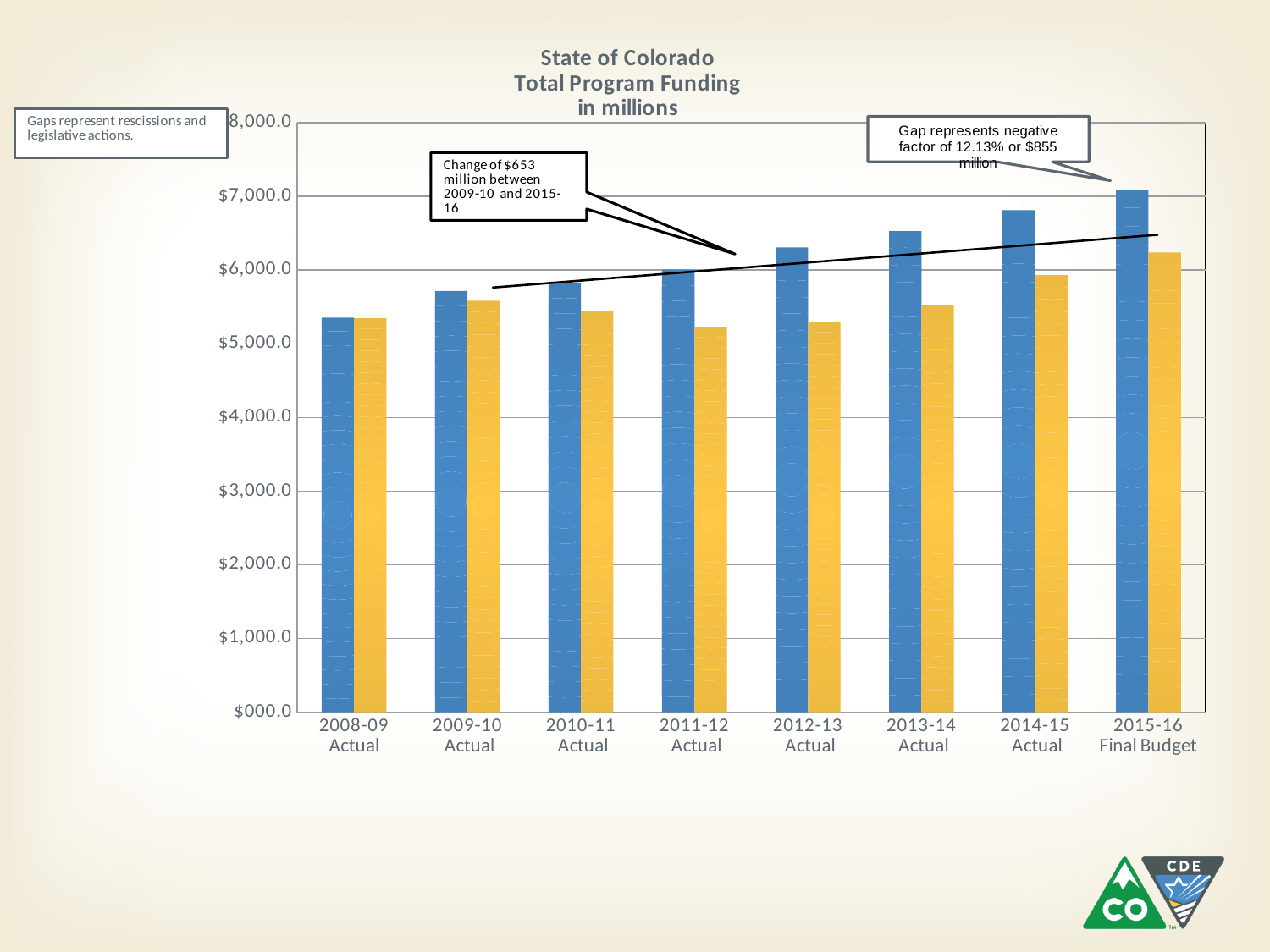
What is the title of the chart? State of Colorado Total Program Funding in millions What kind of chart is shown on the slide? bar chart Which fiscal year has the tallest yellow bar? 2015-16 Final Budget Is the blue bar for 2014-15 Actual greater or less than $7,000.0? less How many bars are plotted for each fiscal year? 2 Which fiscal year has the tallest blue bar? 2015-16 Final Budget Is the blue bar for 2015-16 Final Budget greater or less than $6,000.0? greater Which fiscal year has the shortest blue bar? 2008-09 Actual How many fiscal-year categories are shown on the x axis? 8 Do the blue bars rise or fall from 2008-09 to 2015-16? rise In 2015-16 Final Budget, which bar is taller, the blue bar or the yellow bar? the blue bar Is the yellow bar for 2011-12 Actual greater or less than $6,000.0? less